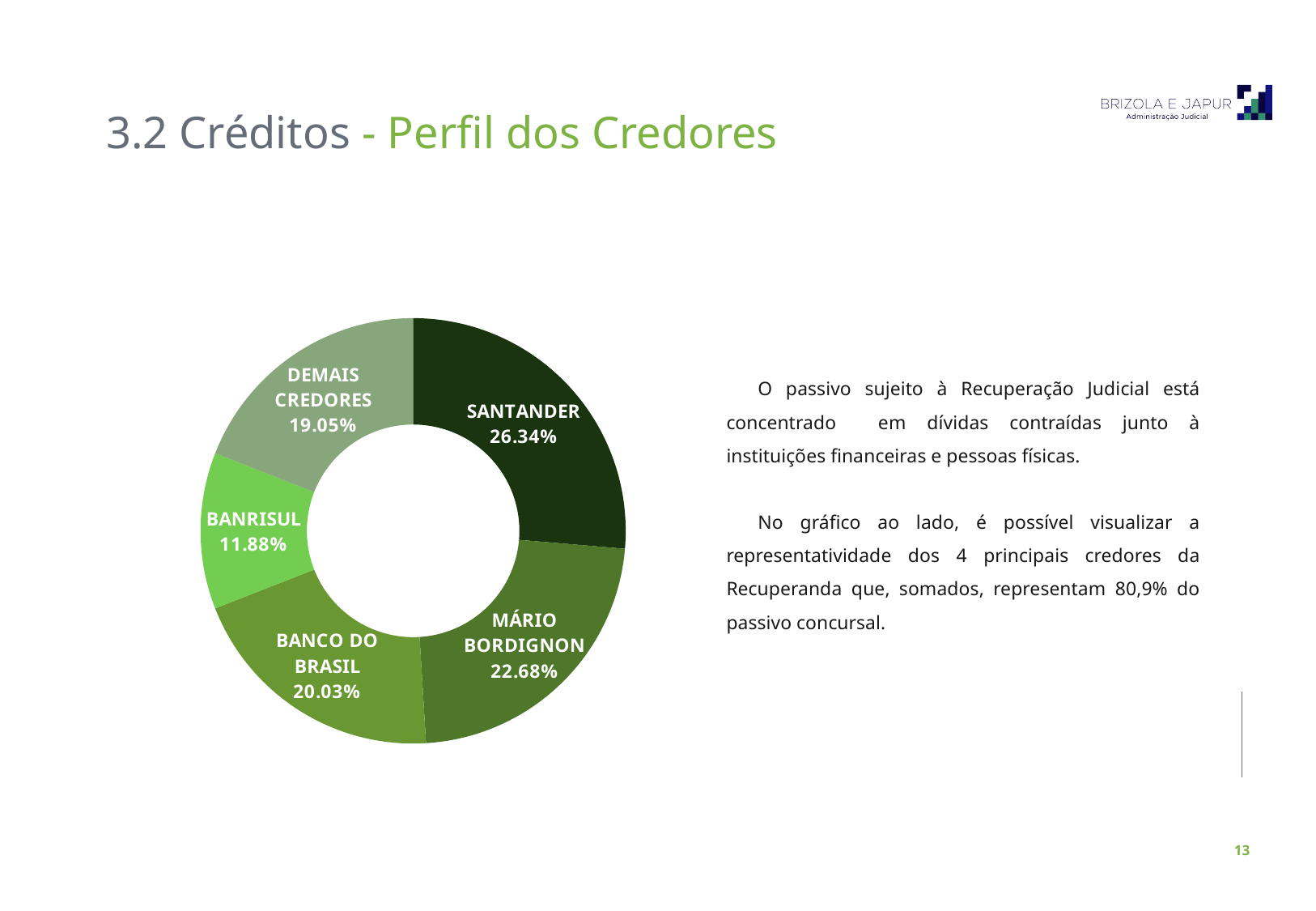
What share of the pie chart does Santander represent? 26.34% What is the difference in percentage points between Mário Bordignon and Banco do Brasil? 2.65 How many slices does the pie chart have? 5 What kind of chart is shown on the slide? Doughnut chart What percentage is shown for Banrisul in the pie chart? 11.88% What percentage is shown for Mário Bordignon? 22.68% What is the difference in percentage points between Santander and Banrisul? 14.46 Which is larger, the share for Santander or the share for Mário Bordignon? Santander What value is labelled for Banco do Brasil? 20.03% Which slice of the pie chart is the smallest? Banrisul Which is larger, the share for Demais Credores or the share for Banrisul? Demais Credores Which creditor has the largest slice of the pie chart? Santander